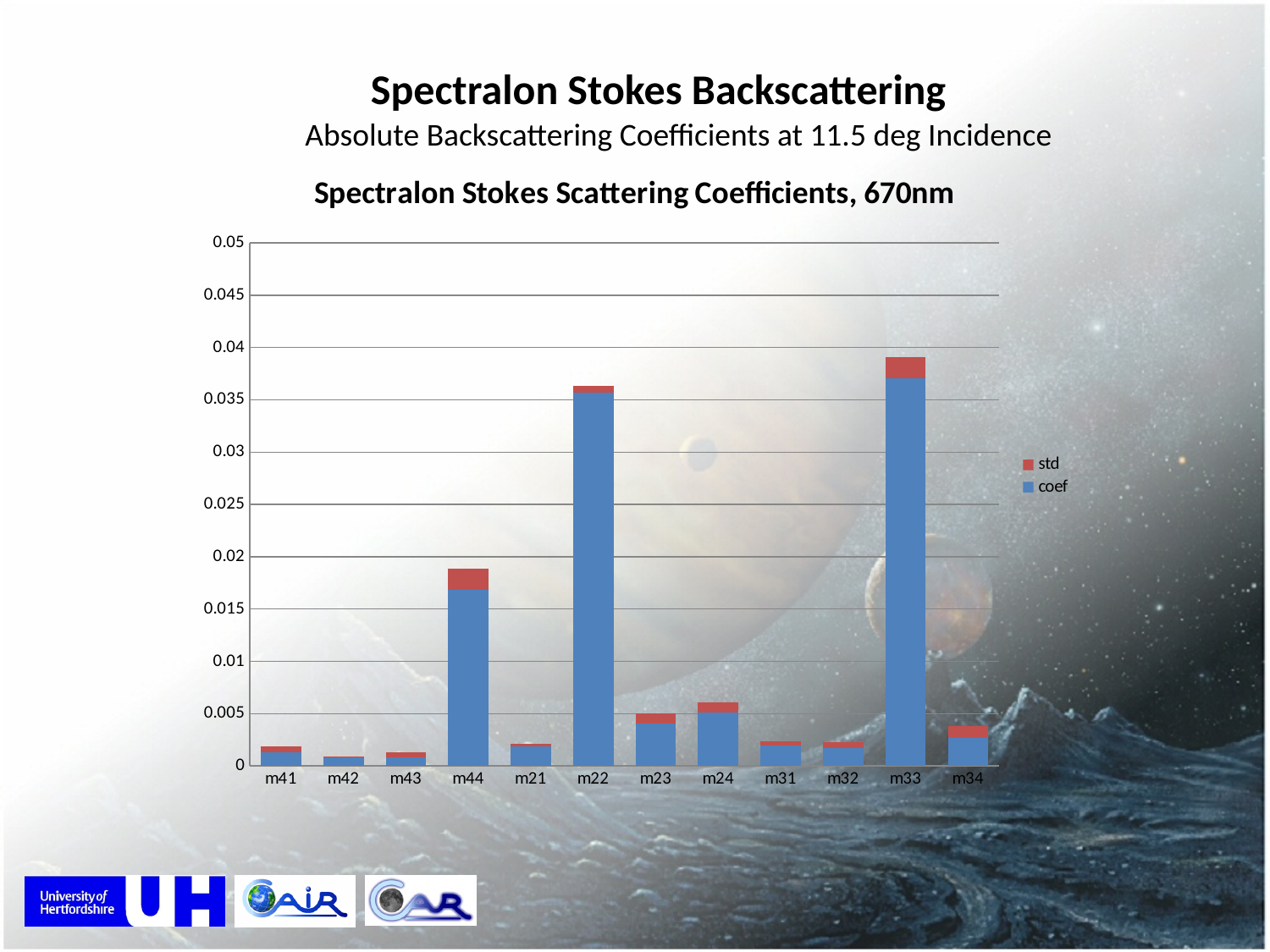
Which stacked bar is taller, m24 or m31? m24 Which series is shown in blue in the chart? coef What is the title of the chart? Spectralon Stokes Scattering Coefficients, 670nm Which stacked bar is taller, m22 or m44? m22 Is the total stacked value for m41 greater or less than 0.005? less How many categories are shown along the x axis of the chart? 12 How many series does the chart's legend list? 2 Is the total stacked value for m44 greater or less than 0.02? less Is the total stacked value for m22 greater or less than 0.03? greater Which category has the highest stacked bar? m33 What kind of chart is shown on the slide? bar chart